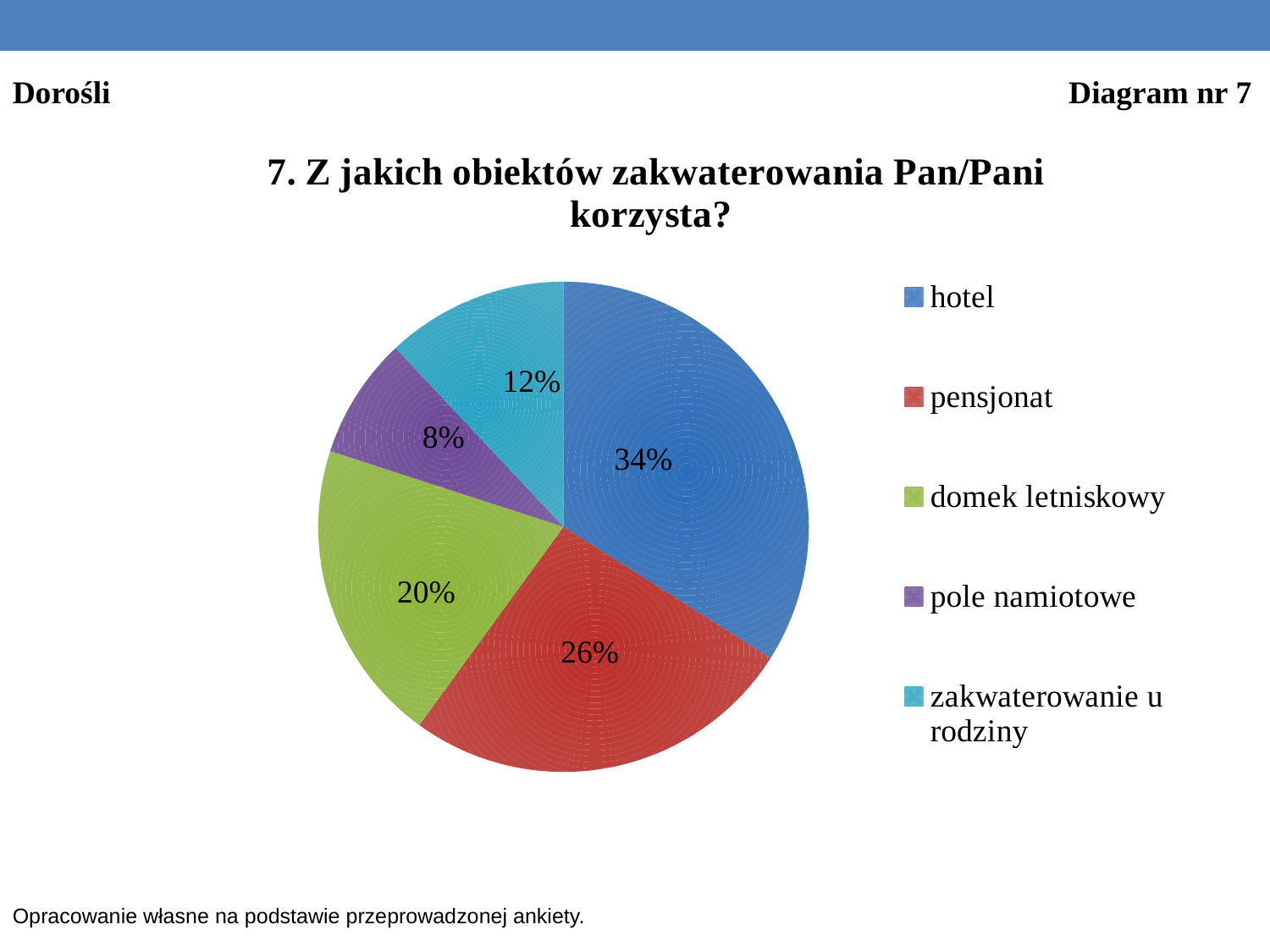
Which category has the smallest share? pole namiotowe What is the difference between the shares of hotel and pensjonat? 8% What share of the pie does hotel have? 34% Which category has the largest share? hotel What is the value for zakwaterowanie u rodziny? 12% What is the value for pensjonat? 26% What is the value for domek letniskowy? 20% How many categories does the pie chart have? 5 What type of chart is shown on the slide? pie chart What is the value for pole namiotowe? 8% Which is larger, domek letniskowy or zakwaterowanie u rodziny? domek letniskowy What is the title of the chart? 7. Z jakich obiektów zakwaterowania Pan/Pani korzysta?